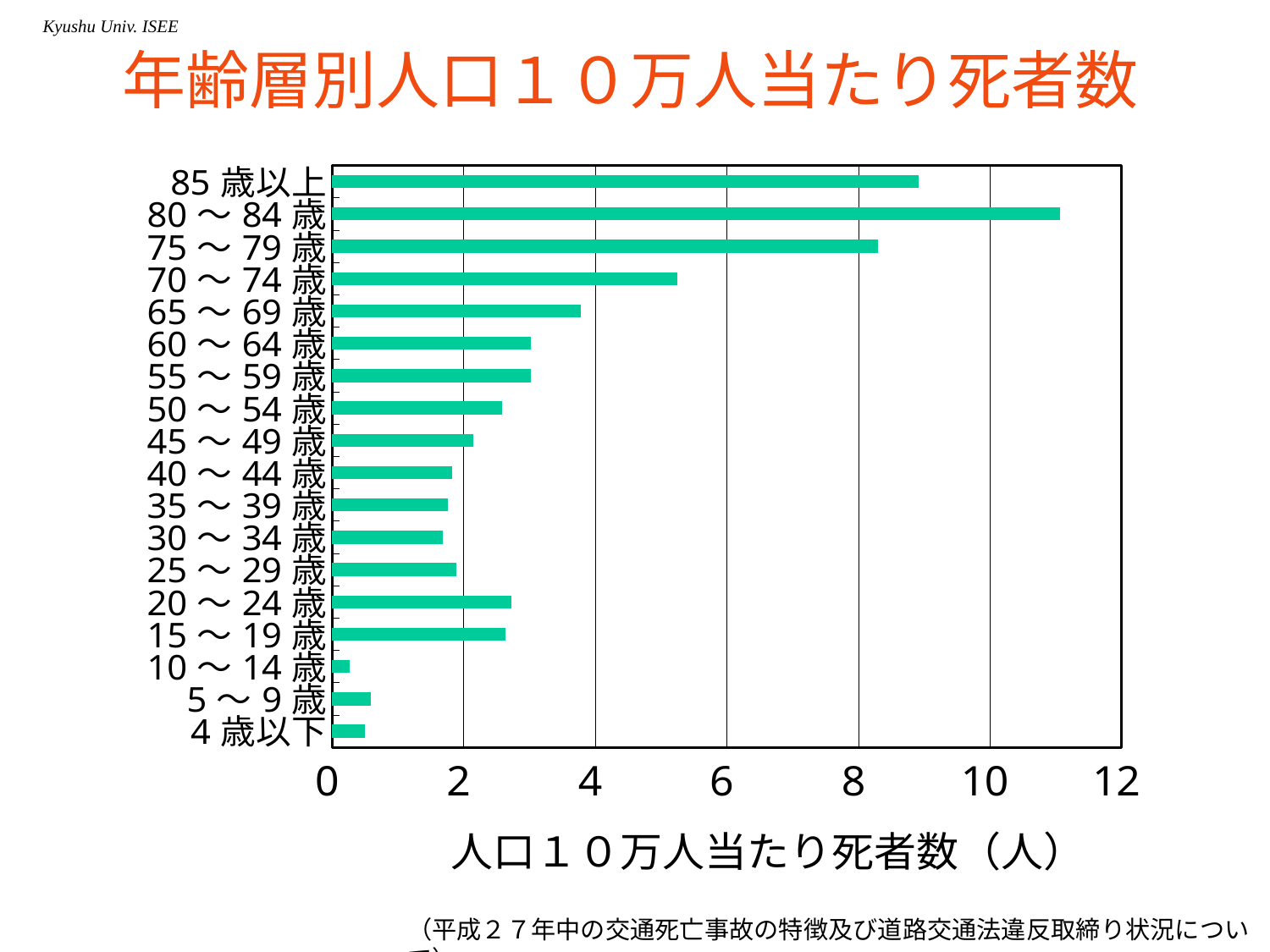
Is the value for 4歳以下 greater or less than 2? less Which has a larger value, 20～24歳 or 30～34歳? 20～24歳 Which has a larger value, 70～74歳 or 65～69歳? 70～74歳 Is the value for 80～84歳 greater or less than 10? greater What is the label of the horizontal axis of the chart? 人口１０万人当たり死者数（人） Which age group has the lowest number of deaths per 100,000 population? 10～14歳 Which age group has the highest number of deaths per 100,000 population? 80～84歳 Is the value for 65～69歳 greater or less than 4? less How many age-group categories are plotted in the chart? 18 What kind of chart is shown on the slide? bar chart